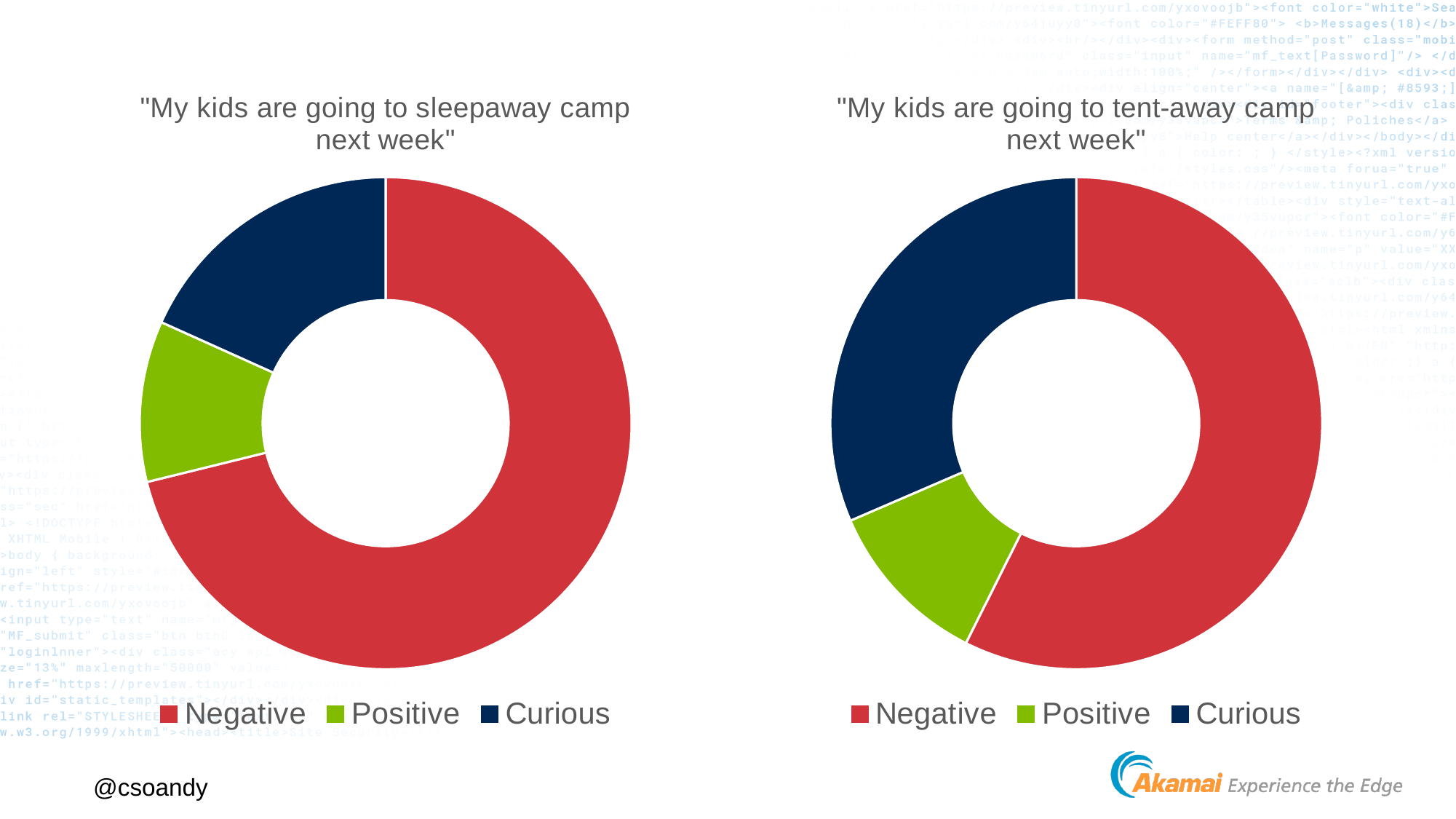
How many categories does the chart titled "My kids are going to sleepaway camp next week" show? 3 What kind of chart is the chart titled "My kids are going to tent-away camp next week"? Pie chart (donut) In the chart titled "My kids are going to tent-away camp next week", which category has the smallest slice? Positive In the chart titled "My kids are going to sleepaway camp next week", which category has the largest slice? Negative In the chart titled "My kids are going to tent-away camp next week", which category has the largest slice? Negative What is the title of the chart on the left side of the slide? "My kids are going to sleepaway camp next week" In the chart titled "My kids are going to sleepaway camp next week", which category has the smallest slice? Positive What kind of chart is the chart titled "My kids are going to sleepaway camp next week"? Pie chart (donut) How many entries does the legend of the chart titled "My kids are going to tent-away camp next week" list? 3 In the chart titled "My kids are going to tent-away camp next week", which slice is larger: Negative or Curious? Negative In the chart titled "My kids are going to sleepaway camp next week", which slice is larger: Curious or Positive? Curious In the chart on the right, which colour represents the Curious category? Dark blue